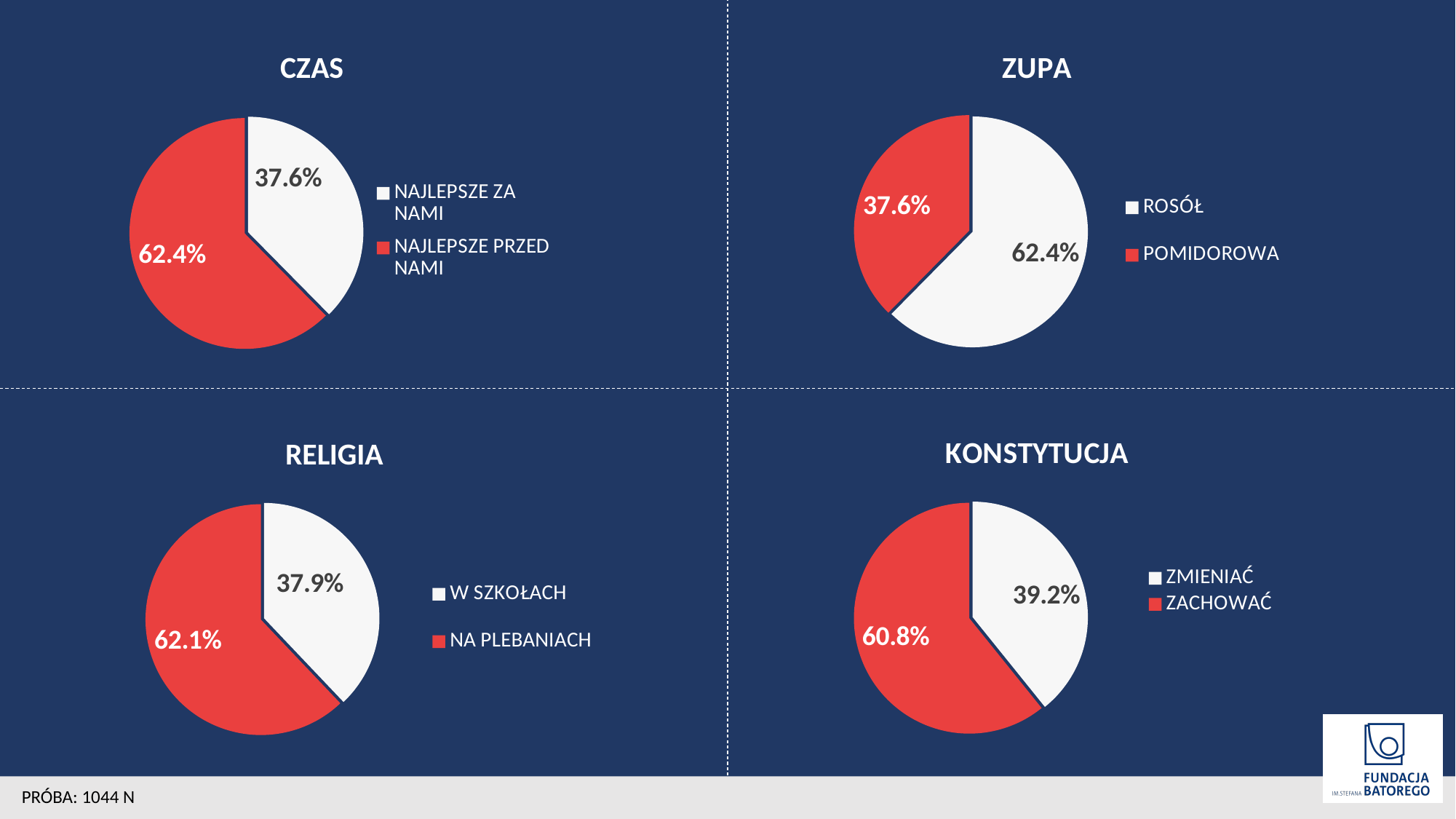
In the KONSTYTUCJA chart, which is larger, ZMIENIAĆ or ZACHOWAĆ? ZACHOWAĆ In the RELIGIA chart, what is the difference between the NA PLEBANIACH and W SZKOŁACH shares? 24.2% In the KONSTYTUCJA chart, what share is labelled for ZACHOWAĆ? 60.8% In the CZAS chart, what share is labelled for NAJLEPSZE ZA NAMI? 37.6% What kind of chart is the CZAS chart? Pie chart In the ZUPA chart, which slice is the smallest? POMIDOROWA In the ZUPA chart, what share is labelled for POMIDOROWA? 37.6% How many entries does the legend of the RELIGIA chart list? 2 In the ZUPA chart, what share is labelled for ROSÓŁ? 62.4% In the RELIGIA chart, what share is labelled for W SZKOŁACH? 37.9% In the CZAS chart, what share is labelled for NAJLEPSZE PRZED NAMI? 62.4% In the KONSTYTUCJA chart, which slice is the largest? ZACHOWAĆ